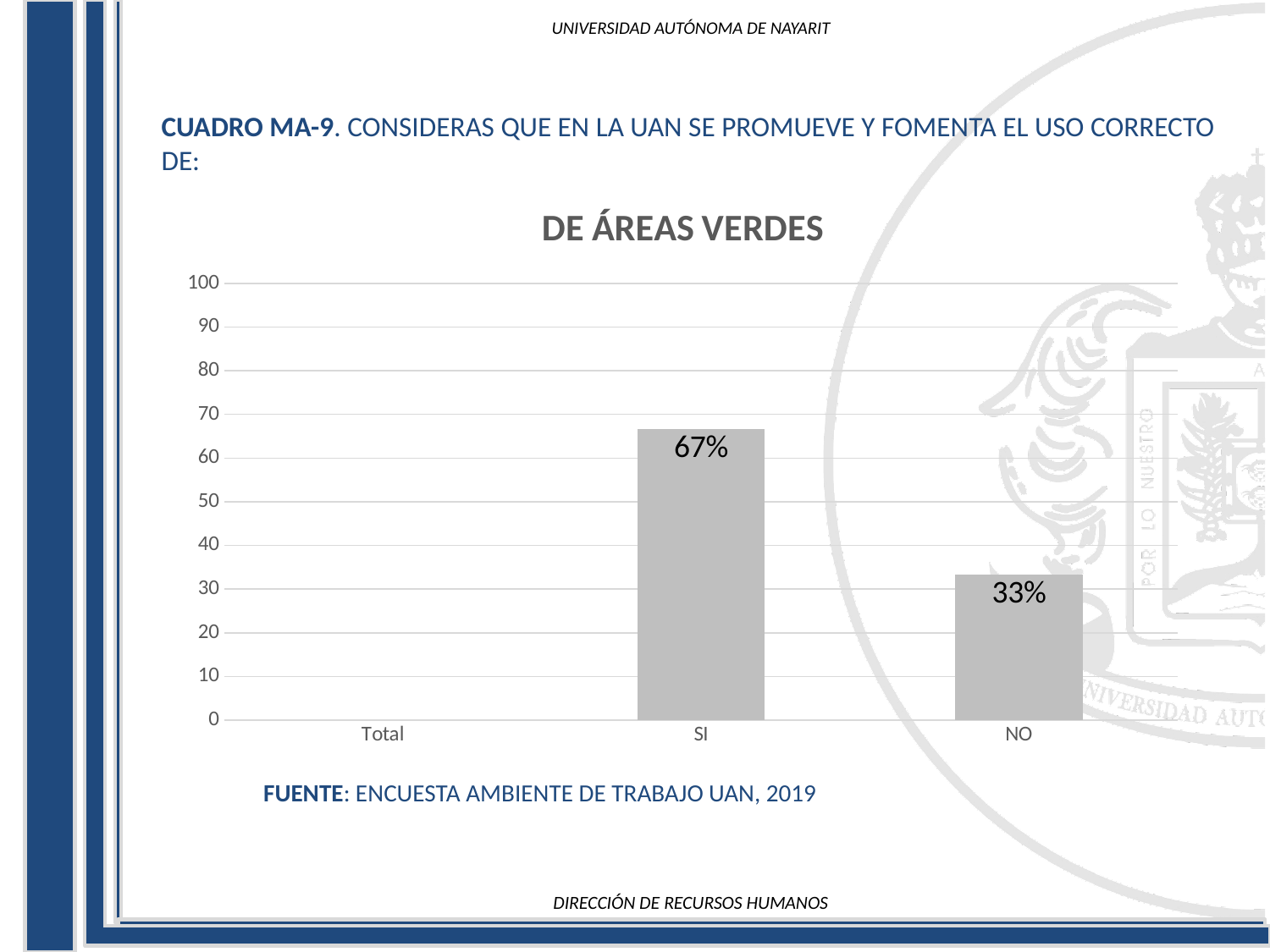
Which category with a visible bar has the lowest value? NO What kind of chart is shown? bar chart What is the difference between the values for SI and NO? 34% Which category has the highest value? SI What is the maximum value shown on the y axis? 100 Which is larger, the value for SI or the value for NO? SI Is the value for SI greater or less than 60? greater What is the title of the chart? DE ÁREAS VERDES What is the value for NO? 33% Is the value for NO greater or less than 40? less What is the value for SI? 67% How many categories are shown on the x axis? 3